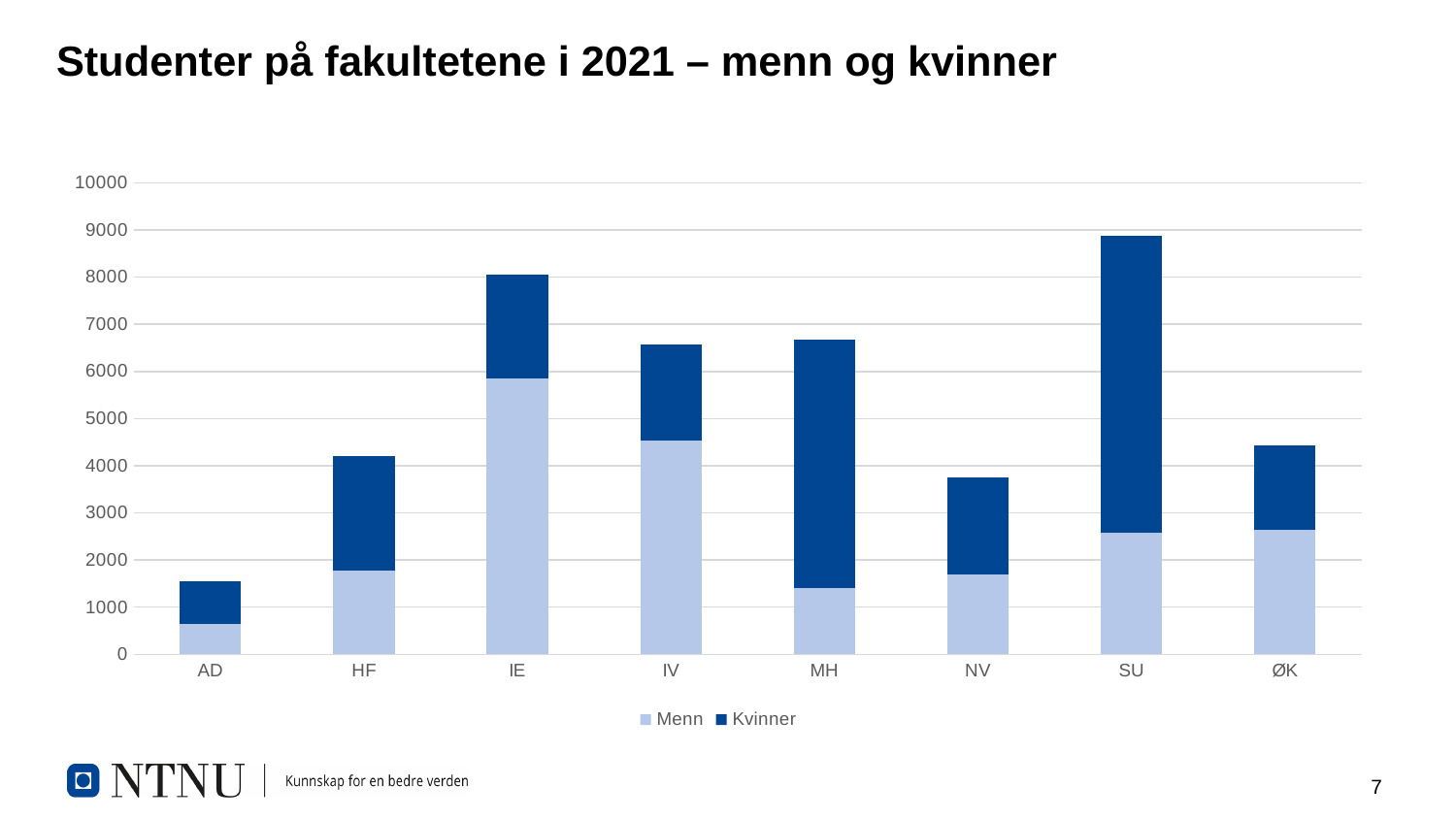
Is the total bar height for NV greater or less than 4000? less Which faculty has the tallest stacked bar (most students in total)? SU What is the title of the chart on the slide? Studenter på fakultetene i 2021 – menn og kvinner What kind of chart is shown on the slide? Stacked bar chart Is the total bar height for AD greater or less than 2000? less Which faculty has the larger total bar, HF or MH? MH How many series does the legend list? 2 Which faculty has the shortest stacked bar (fewest students in total)? AD Is the Menn segment for IE greater or less than 5000? greater Which faculty has the larger Menn segment, IE or SU? IE How many faculties (categories) are shown on the x axis? 8